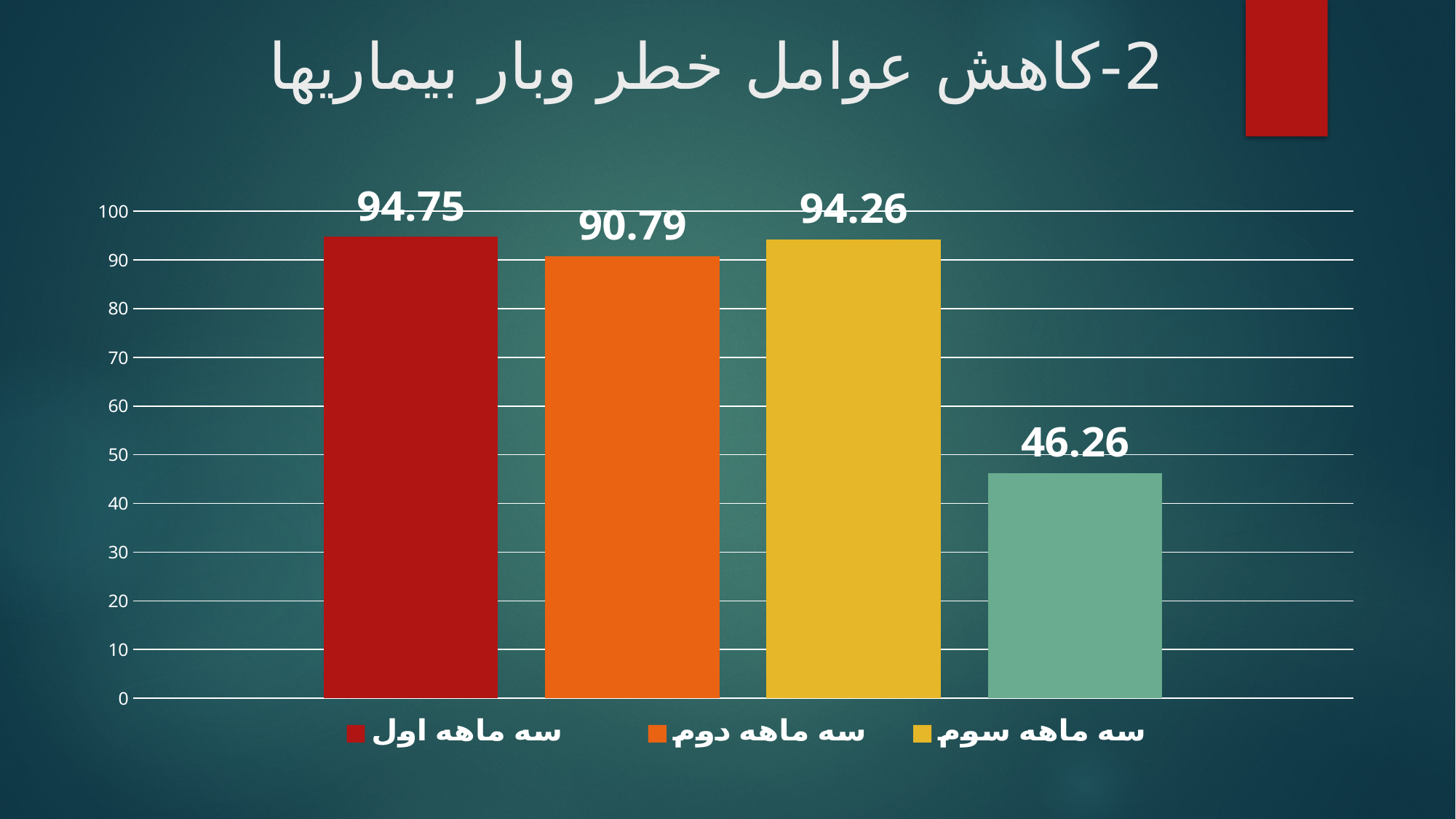
How many series does the legend list? 3 What kind of chart is shown on the slide? Bar chart Which legend series has the highest value? سه ماهه اول Is the value of the fourth (teal) bar greater or less than 50? less What is the lowest value shown in the chart? 46.26 What is the value shown on the fourth (teal) bar at the right of the chart? 46.26 What is the difference between the values for سه ماهه اول and سه ماهه دوم? 3.96 Which is larger, the value for سه ماهه دوم or سه ماهه سوم? سه ماهه سوم How many bars are plotted in the chart? 4 What is the value for سه ماهه سوم? 94.26 What is the value for سه ماهه اول? 94.75 What is the value for سه ماهه دوم? 90.79